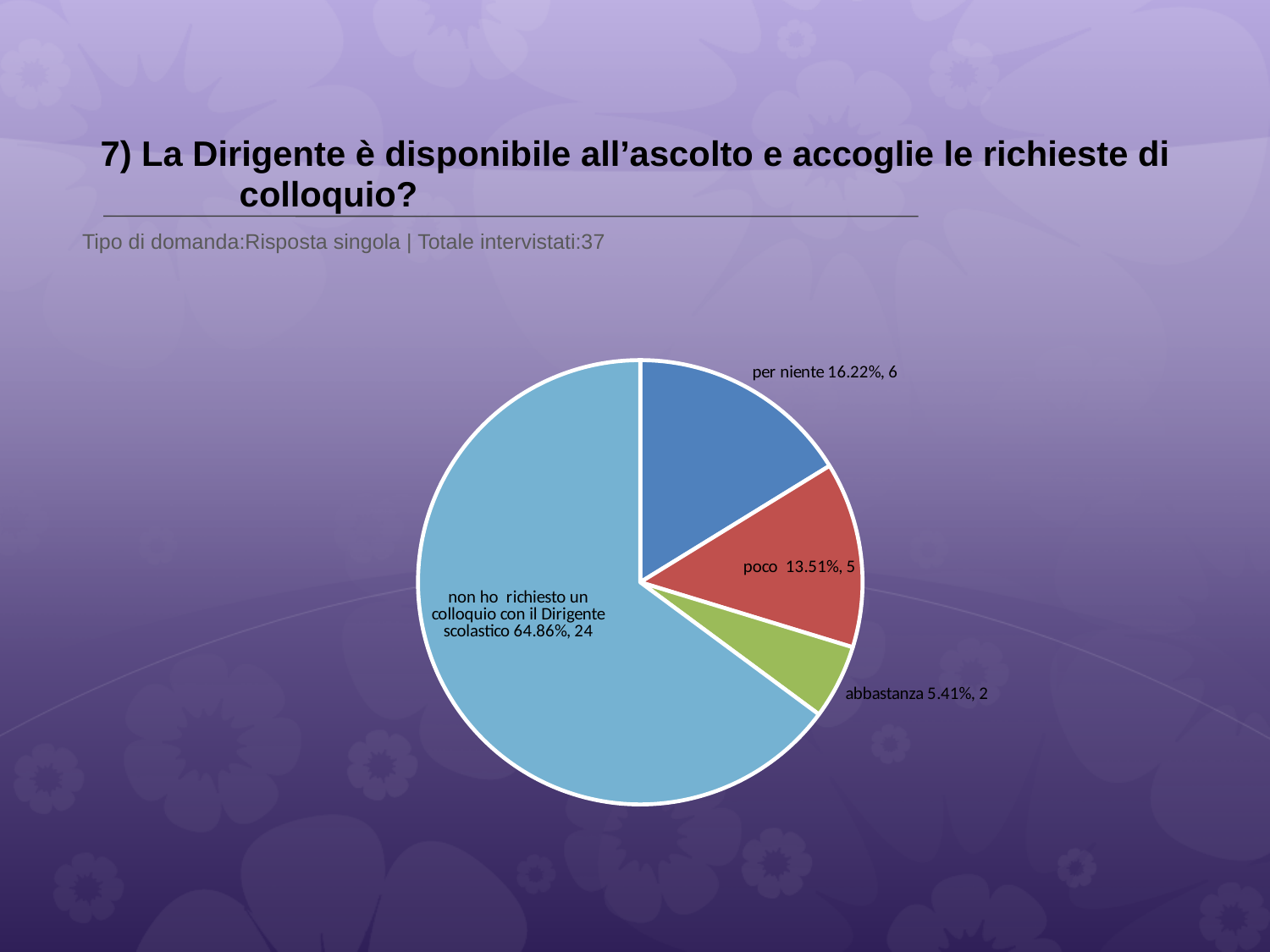
What percentage of respondents answered "abbastanza"? 5.41% What kind of chart is shown on the slide? pie chart What percentage of respondents answered "per niente"? 16.22% Which response received more respondents, "poco" or "abbastanza"? poco How many more respondents answered "per niente" than "poco"? 1 What is the total number of respondents shown in the subtitle? 37 How many respondents answered "non ho richiesto un colloquio con il Dirigente scolastico"? 24 How many slices does the pie chart have? 4 How many respondents answered "poco"? 5 Which response has the largest share of the pie? non ho richiesto un colloquio con il Dirigente scolastico Which response has the smallest share of the pie? abbastanza What colour is the slice for "abbastanza"? green